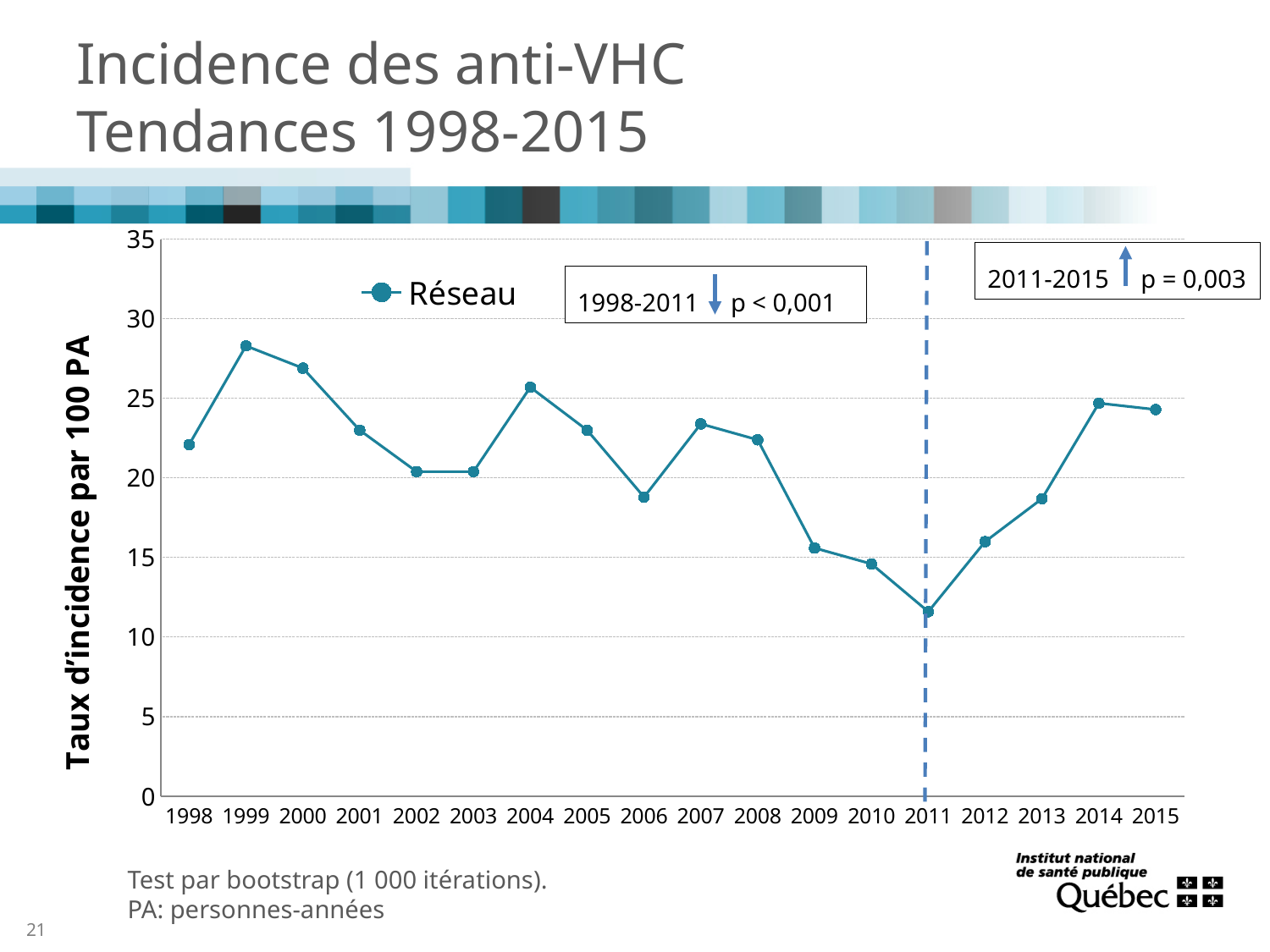
How many series does the legend list? 1 Which year has the larger value, 2010 or 2014? 2014 What is the name of the series shown in the legend? Réseau Is the value for 2006 greater or less than 20? less Which year has the highest incidence rate? 1999 How many years are plotted along the x axis? 18 Is the value for 1999 greater or less than 25? greater Do the values generally rise or fall from 1998 to 2011? fall Is the value for 2011 greater or less than 15? less What is the title of the y axis? Taux d'incidence par 100 PA Which year has the lowest incidence rate? 2011 What kind of chart is shown on the slide? line chart